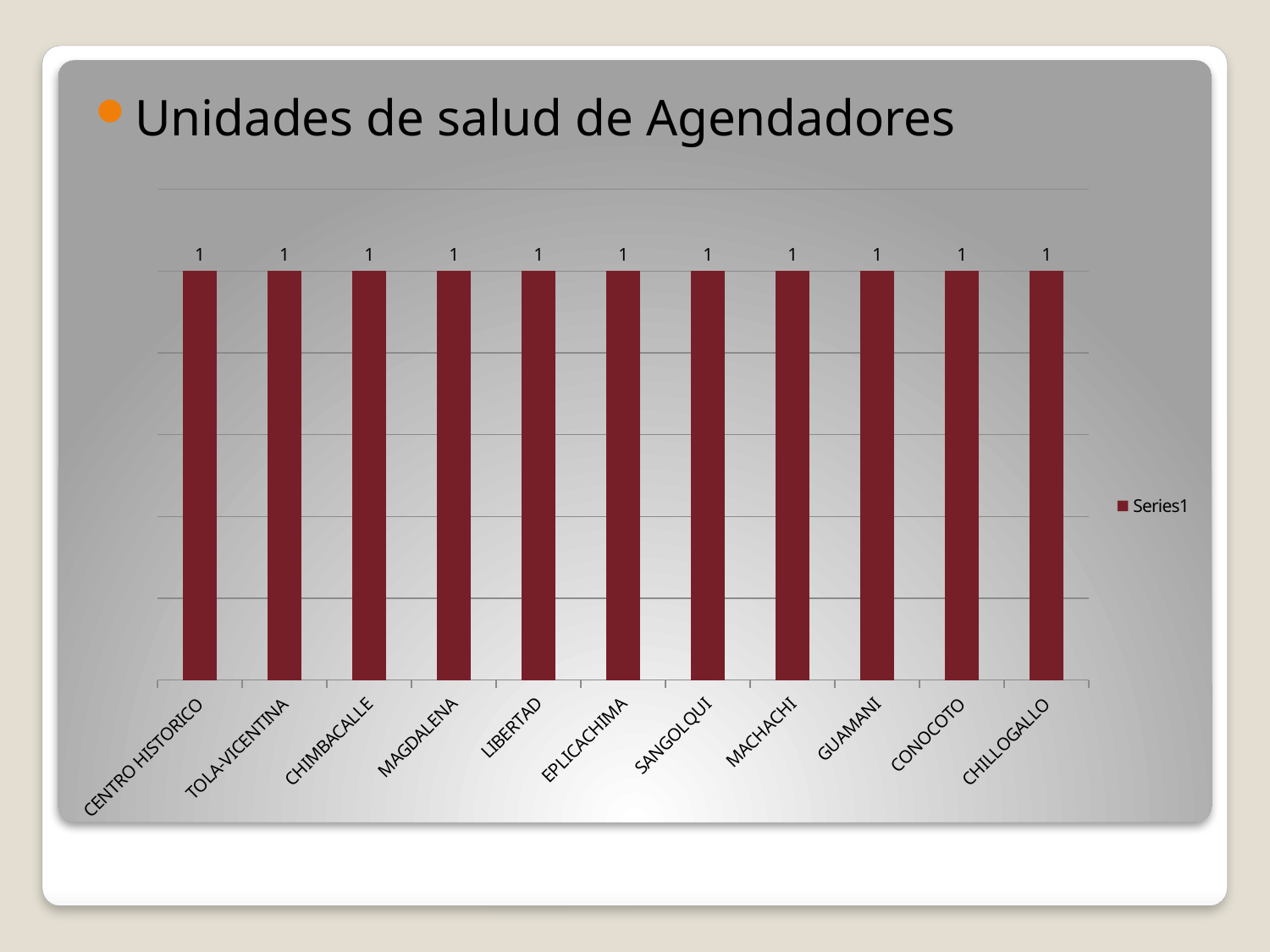
Do the values rise, fall, or stay flat across the categories from left to right? stay flat How many categories are shown on the x axis? 11 What is the value for CHILLOGALLO? 1 What is the value for SANGOLQUI? 1 Is the value for MACHACHI larger than, smaller than, or equal to the value for CONOCOTO? equal What is the value for MAGDALENA? 1 What kind of chart is shown on the slide? bar chart What is the title shown above the chart? Unidades de salud de Agendadores How many series does the legend list? 1 What is the difference between the values for LIBERTAD and GUAMANI? 0 What is the name of the series shown in the legend? Series1 What is the value for CENTRO HISTORICO? 1